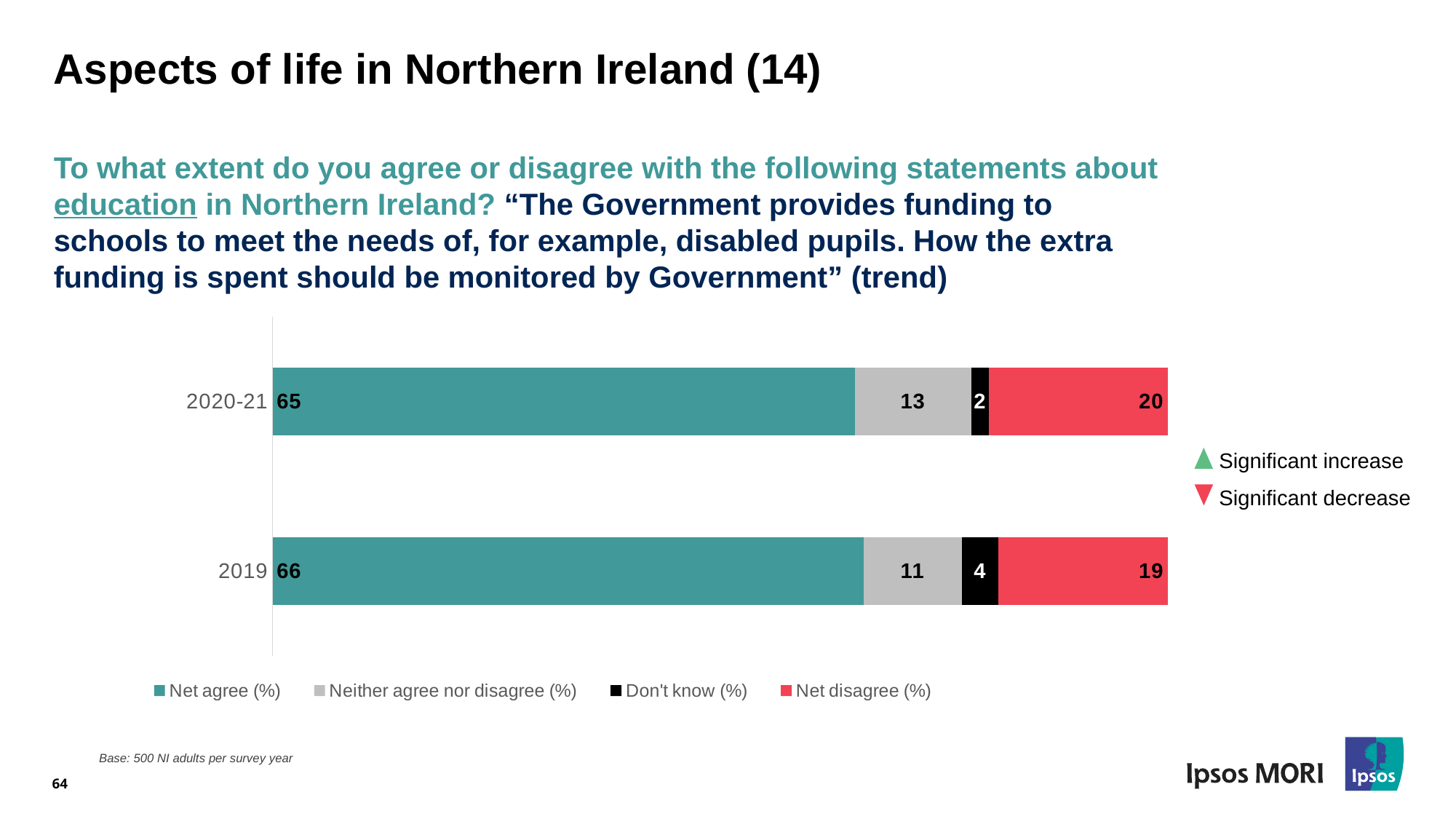
What is the Net disagree (%) value for 2019? 19 How many series does the legend list? 4 What is the Neither agree nor disagree (%) value for 2020-21? 13 How many categories (years) are shown on the chart? 2 What is the difference between the Net disagree (%) values for 2020-21 and 2019? 1 What is the total of the stacked bar for 2020-21? 100 What is the Don't know (%) value for 2019? 4 What is the difference between the Neither agree nor disagree (%) values for 2020-21 and 2019? 2 What is the Net agree (%) value for 2020-21? 65 Which year has the higher Net agree (%) value? 2019 Which colour represents Net disagree (%) in the chart? Red What kind of chart is shown on the slide? Stacked bar chart